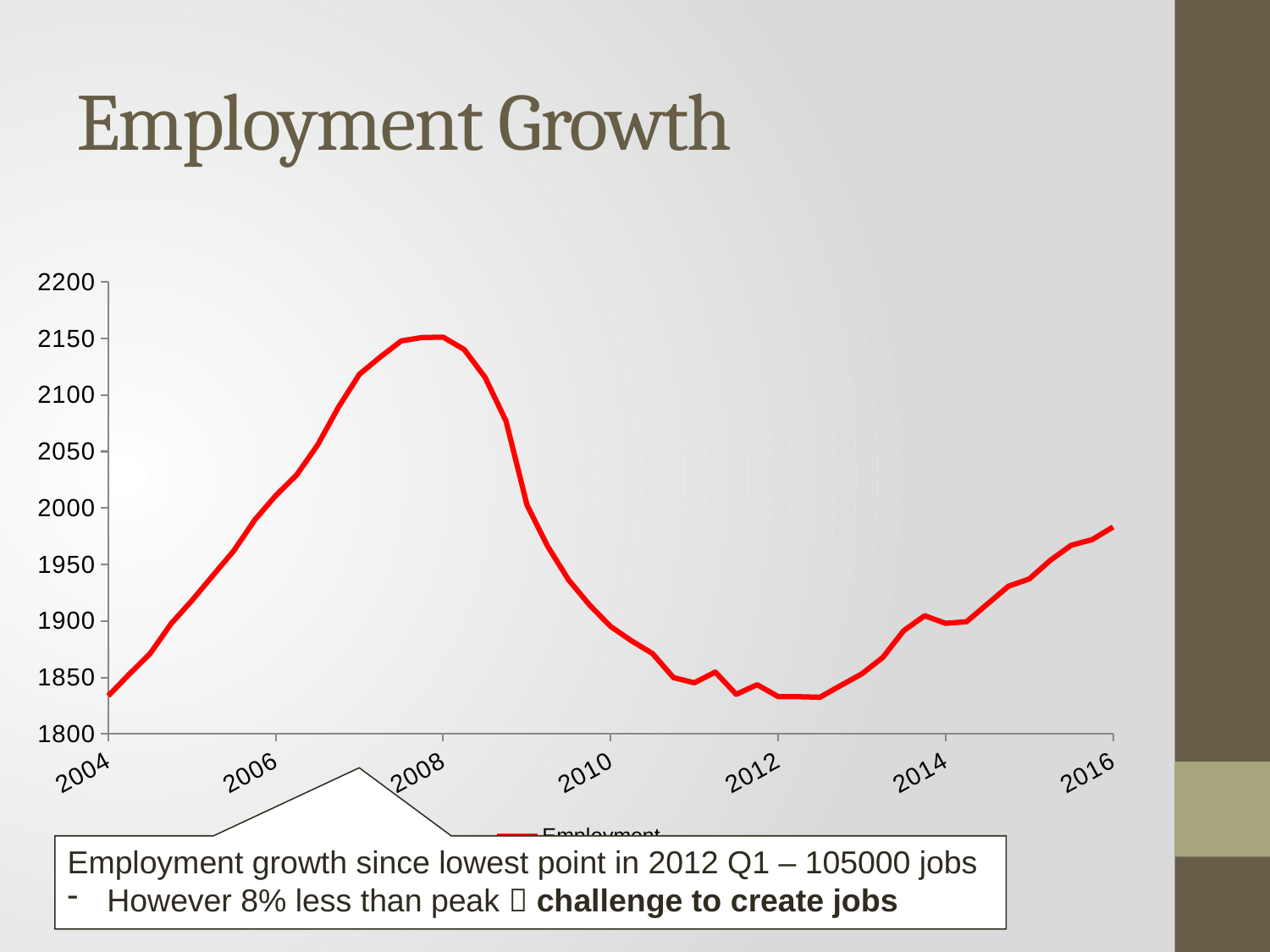
Is the employment value at 2008 greater or less than 2100? greater Does the employment line rise or fall between 2008 and 2012? fall Is the employment value at 2016 greater or less than 1950? greater Which is larger, the employment value at 2008 or at 2012? 2008 Is the employment value at 2004 greater or less than 1850? less How many year labels are shown on the x axis of the chart? 7 Around which year does the employment line reach its lowest point? 2012 What is the title of the slide containing the chart? Employment Growth What kind of chart is shown on the slide? line chart Around which year does the employment line reach its highest point? 2008